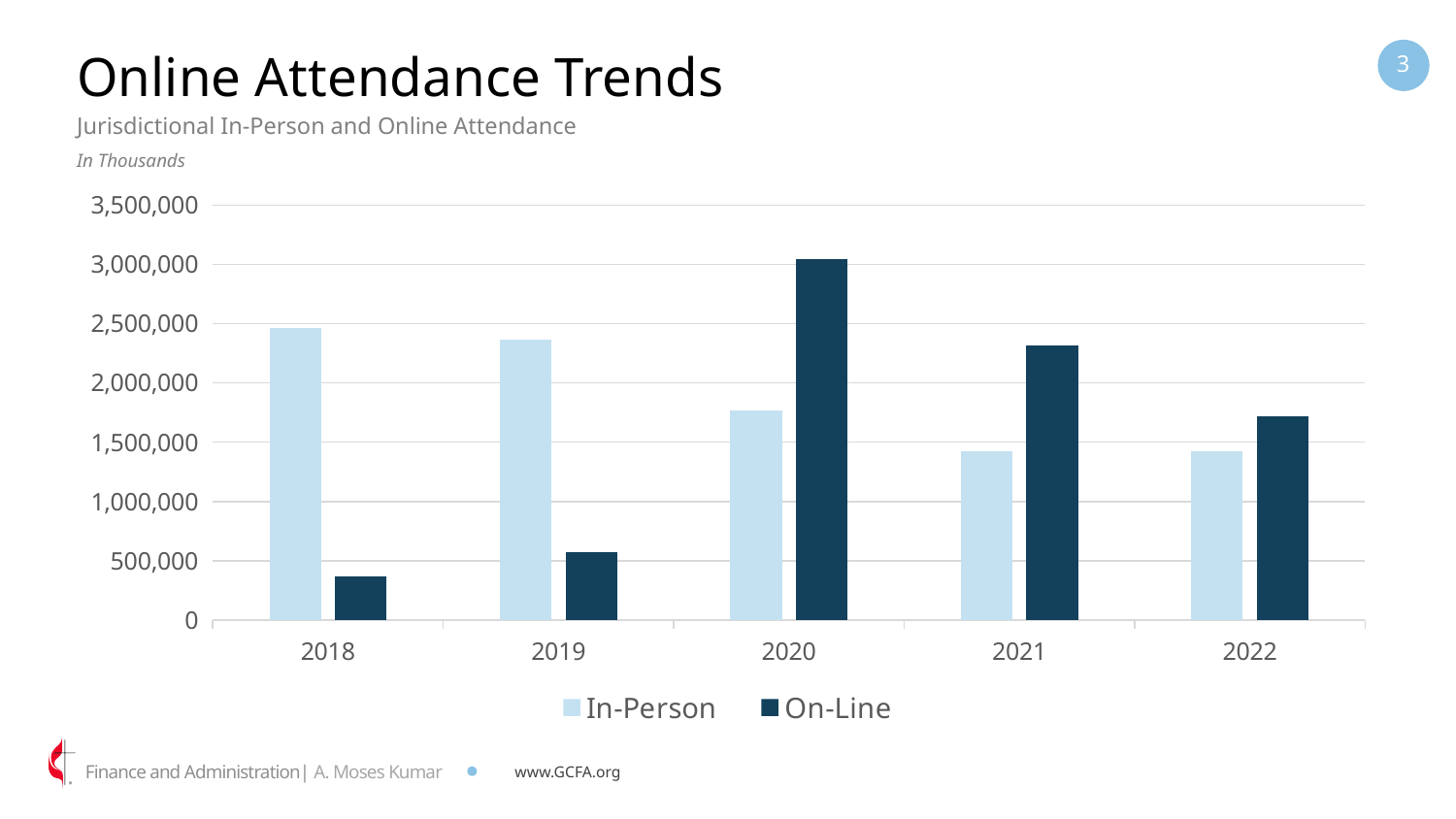
How many years are shown on the x axis? 5 In 2018, which is larger: In-Person or On-Line attendance? In-Person Does In-Person attendance rise or fall from 2018 to 2022? fall In which year is On-Line attendance lowest? 2018 How many series does the legend list? 2 What are the two series named in the legend? In-Person and On-Line Is the On-Line value for 2020 greater or less than 2,500,000? greater Is the On-Line value for 2018 greater or less than 500,000? less What kind of chart is shown on the slide? bar chart In which year is In-Person attendance highest? 2018 In which year is On-Line attendance highest? 2020 In 2020, which is larger: In-Person or On-Line attendance? On-Line